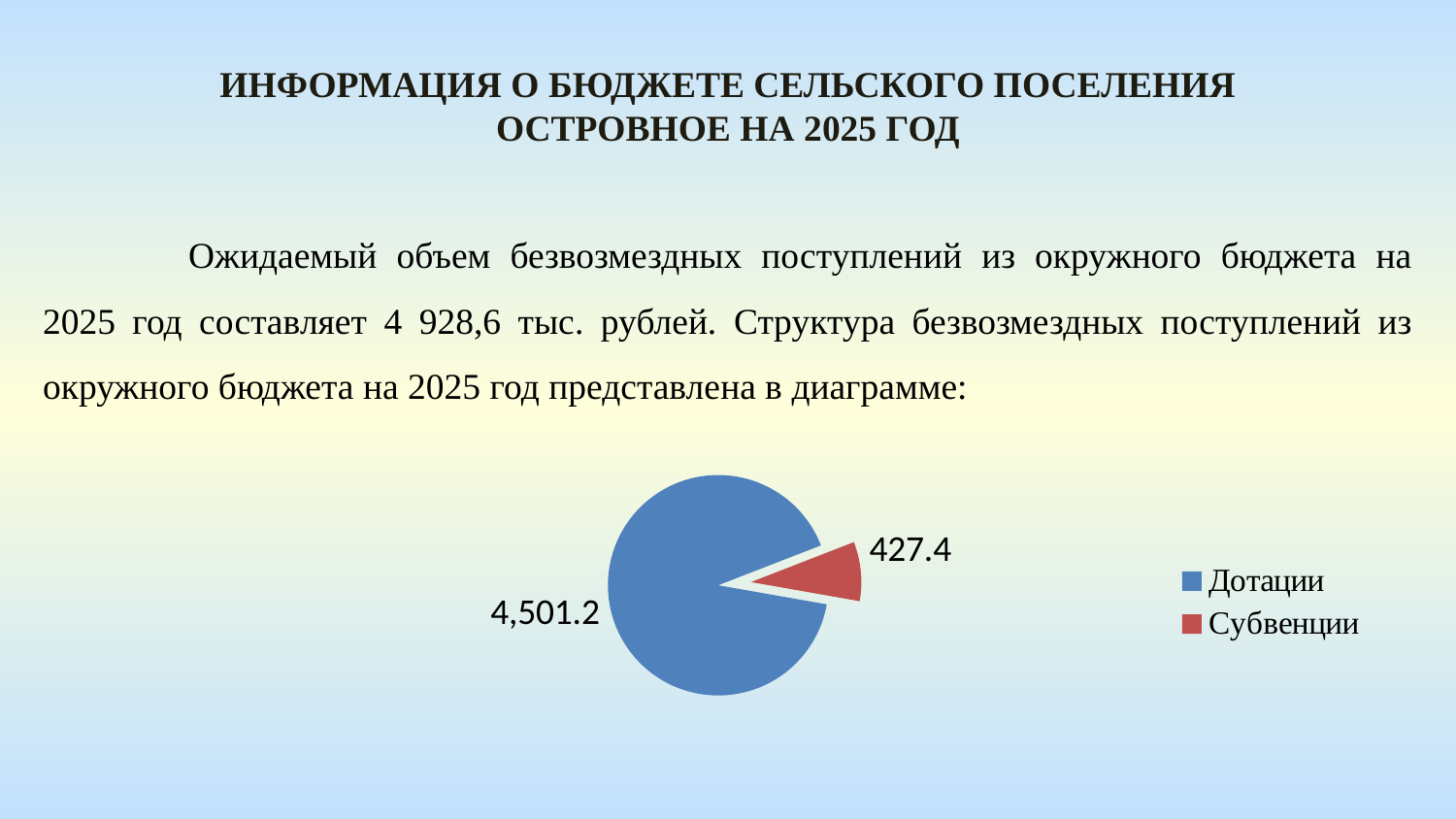
What is the total of the two values shown in the pie chart? 4,928.6 What is the value shown for Субвенции in the pie chart? 427.4 What kind of chart is shown on the slide? Pie chart How many slices does the pie chart have? 2 Which category has the largest slice in the pie chart? Дотации What is the difference between the values for Дотации and Субвенции? 4,073.8 Which is larger, the value for Дотации or the value for Субвенции? Дотации How many entries does the legend list? 2 What colour is the Субвенции slice in the pie chart? Red Which category has the smallest slice in the pie chart? Субвенции What is the value shown for Дотации in the pie chart? 4,501.2